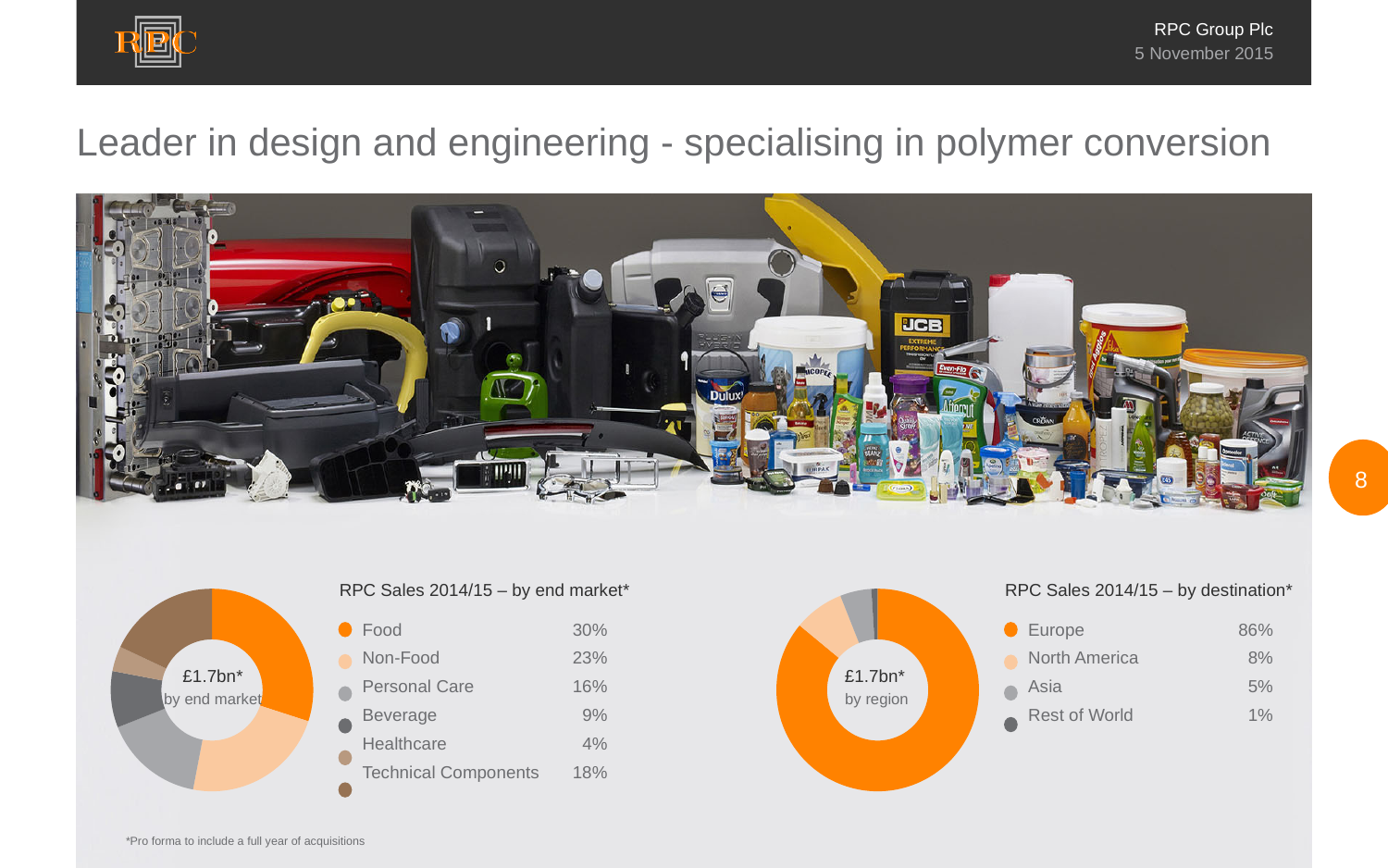
What type of chart is used for 'RPC Sales 2014/15 – by destination'? Pie (donut) chart In the 'RPC Sales 2014/15 – by end market' chart, what share of sales is Technical Components? 18% In the 'RPC Sales 2014/15 – by end market' chart, which end market has the smallest share? Healthcare How many regions are listed in the 'RPC Sales 2014/15 – by destination' chart? 4 In the 'RPC Sales 2014/15 – by end market' chart, which end market has the largest share? Food In the 'RPC Sales 2014/15 – by end market' chart, what share of sales is Food? 30% In the 'RPC Sales 2014/15 – by destination' chart, what share of sales goes to Europe? 86% In the 'RPC Sales 2014/15 – by destination' chart, what share of sales goes to Asia? 5% In the 'RPC Sales 2014/15 – by end market' chart, what is the difference between the Non-Food and Beverage shares? 14% How many end markets are shown in the 'RPC Sales 2014/15 – by end market' chart? 6 In the 'RPC Sales 2014/15 – by end market' chart, which is larger: Personal Care or Technical Components? Technical Components In the 'RPC Sales 2014/15 – by destination' chart, which region has the smallest share? Rest of World